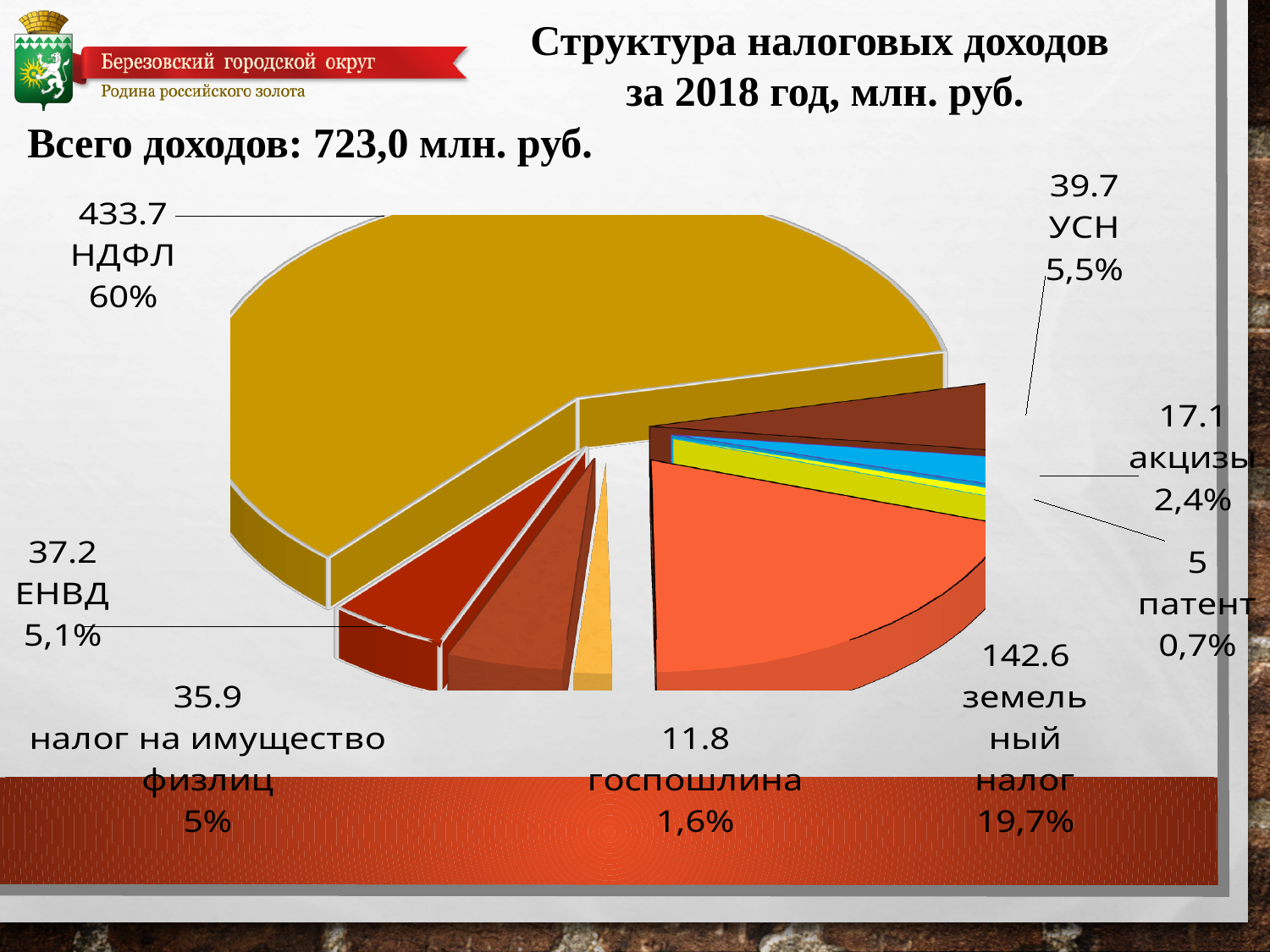
What share of the pie does земельный налог represent? 19,7% Which category has the smallest slice of the pie? патент What is the title of the chart? Структура налоговых доходов за 2018 год, млн. руб. Which is larger, the value for ЕНВД or the value for налог на имущество физлиц? ЕНВД What is the value for земельный налог? 142.6 What is the value for акцизы? 17.1 What is the value for НДФЛ? 433.7 What kind of chart is shown on the slide? pie chart What share of the pie does УСН represent? 5,5% Which category has the largest slice of the pie? НДФЛ What is the difference between the values for НДФЛ and земельный налог? 291.1 How many categories are shown in the pie chart? 8